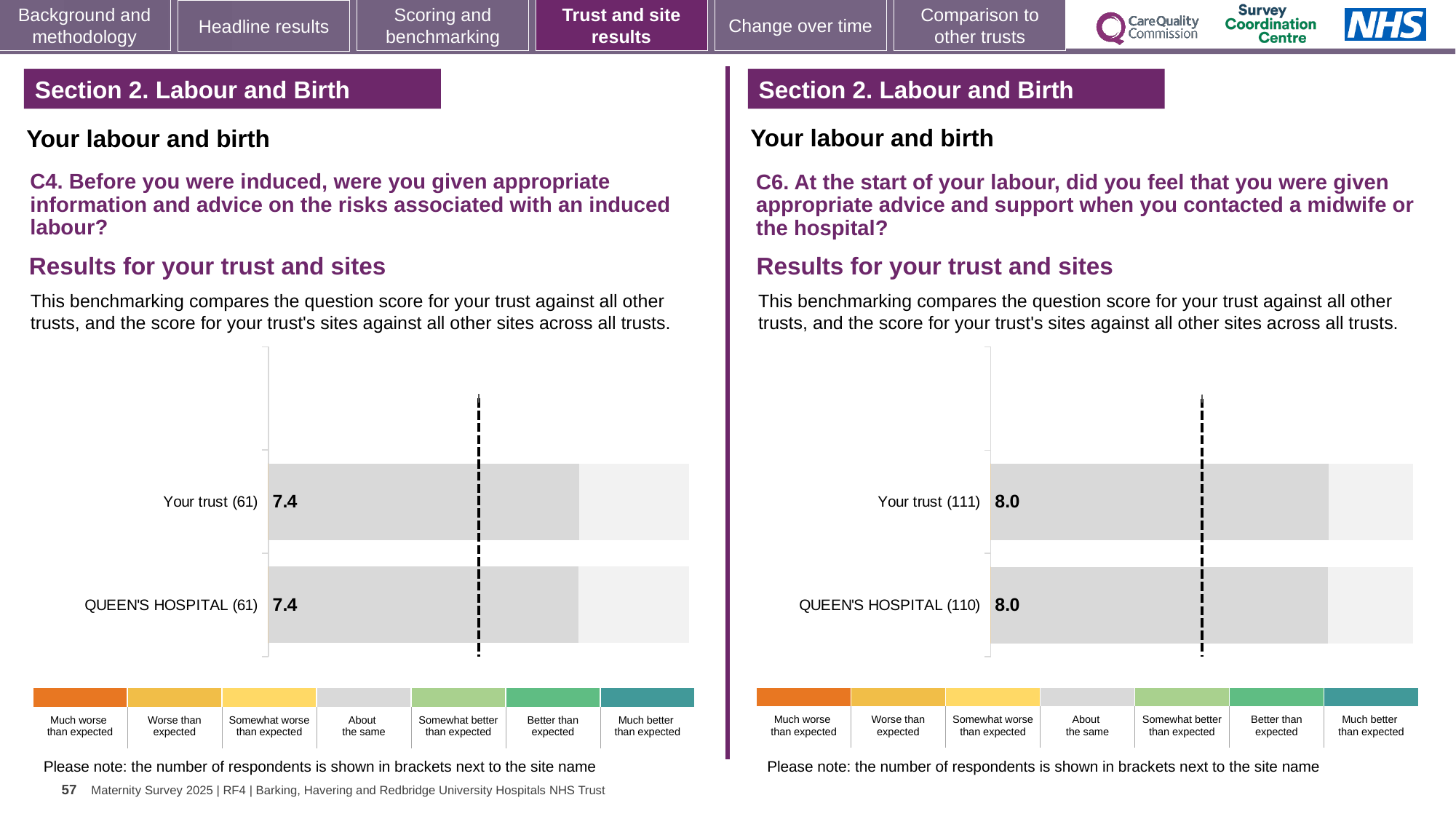
On the left chart (C4), what is the score for Your trust? 7.4 On the left chart (C4), which benchmark category does the grey colour of the bars correspond to in the legend? About the same On the left chart (C4), what is the difference between the Your trust score and the QUEEN'S HOSPITAL score? 0.0 How many bars are plotted on the left chart (C4)? 2 On the right chart (C6), what is the difference between the Your trust score and the QUEEN'S HOSPITAL score? 0.0 On the right chart (C6), how many respondents are shown in brackets for QUEEN'S HOSPITAL? 110 On the right chart (C6), what is the score for QUEEN'S HOSPITAL? 8.0 How many bars are plotted on the right chart (C6)? 2 On the left chart (C4), how many respondents are shown in brackets for Your trust? 61 On the right chart (C6), what is the score for Your trust? 8.0 On the left chart (C4), what is the score for QUEEN'S HOSPITAL? 7.4 What kind of chart is used on the left (C4)? Bar chart